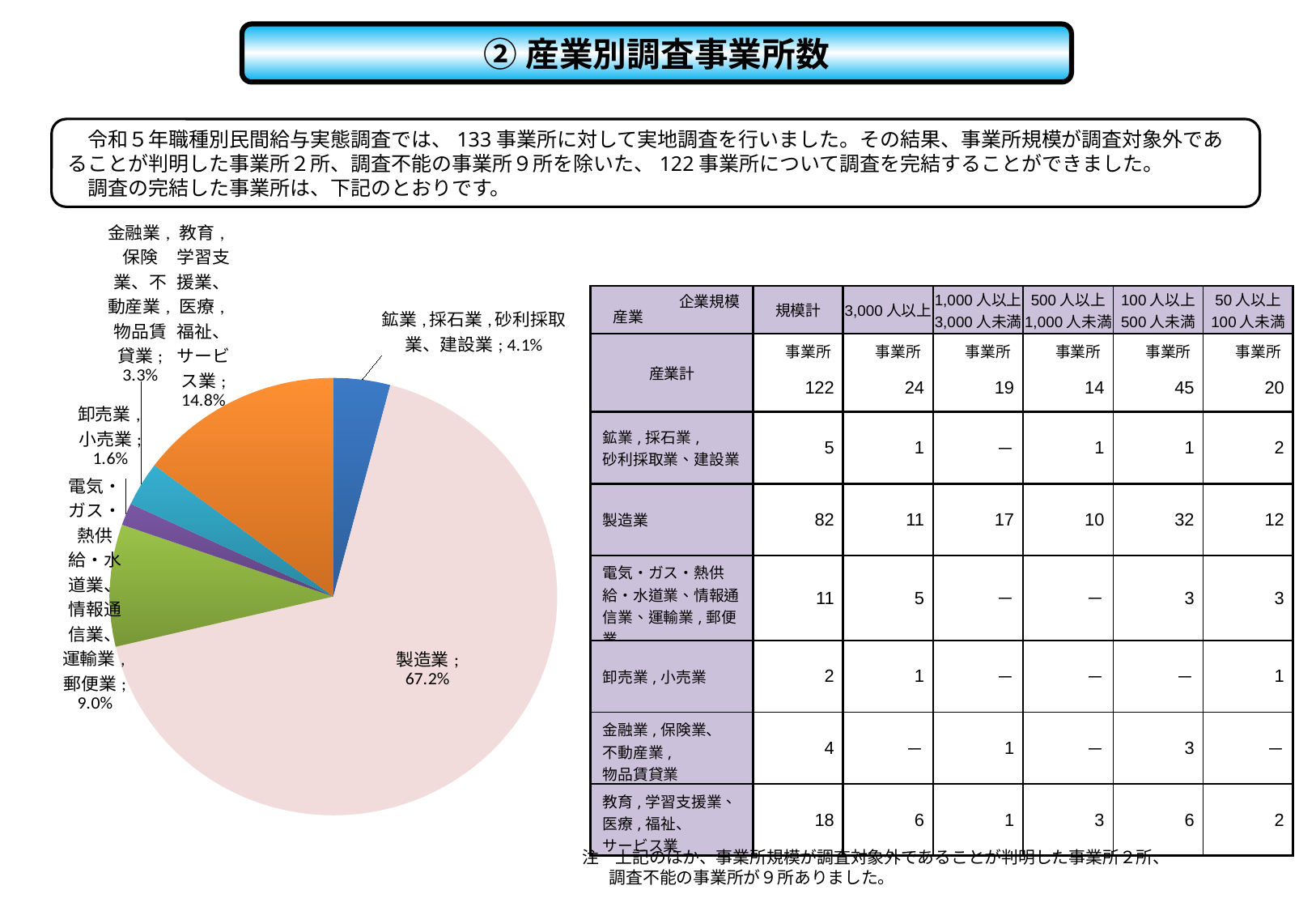
What share of the pie chart does 金融業,保険業、不動産業,物品賃貸業 account for? 3.3% What share of the pie chart does 卸売業,小売業 account for? 1.6% Which industry has the smallest slice in the pie chart? 卸売業,小売業 What share of the pie chart does 製造業 account for? 67.2% What is the difference in percentage points between the 製造業 slice and the 教育,学習支援業、医療,福祉、サービス業 slice in the pie chart? 52.4 What kind of chart is shown on the slide? pie chart What share of the pie chart does 教育,学習支援業、医療,福祉、サービス業 account for? 14.8% In the pie chart, which is larger: the share for 鉱業,採石業,砂利採取業、建設業 or the share for 金融業,保険業、不動産業,物品賃貸業? 鉱業,採石業,砂利採取業、建設業 How many slices does the pie chart have? 6 What share of the pie chart does 鉱業,採石業,砂利採取業、建設業 account for? 4.1% What share of the pie chart does 電気・ガス・熱供給・水道業、情報通信業、運輸業,郵便業 account for? 9.0% Which industry has the largest slice in the pie chart? 製造業